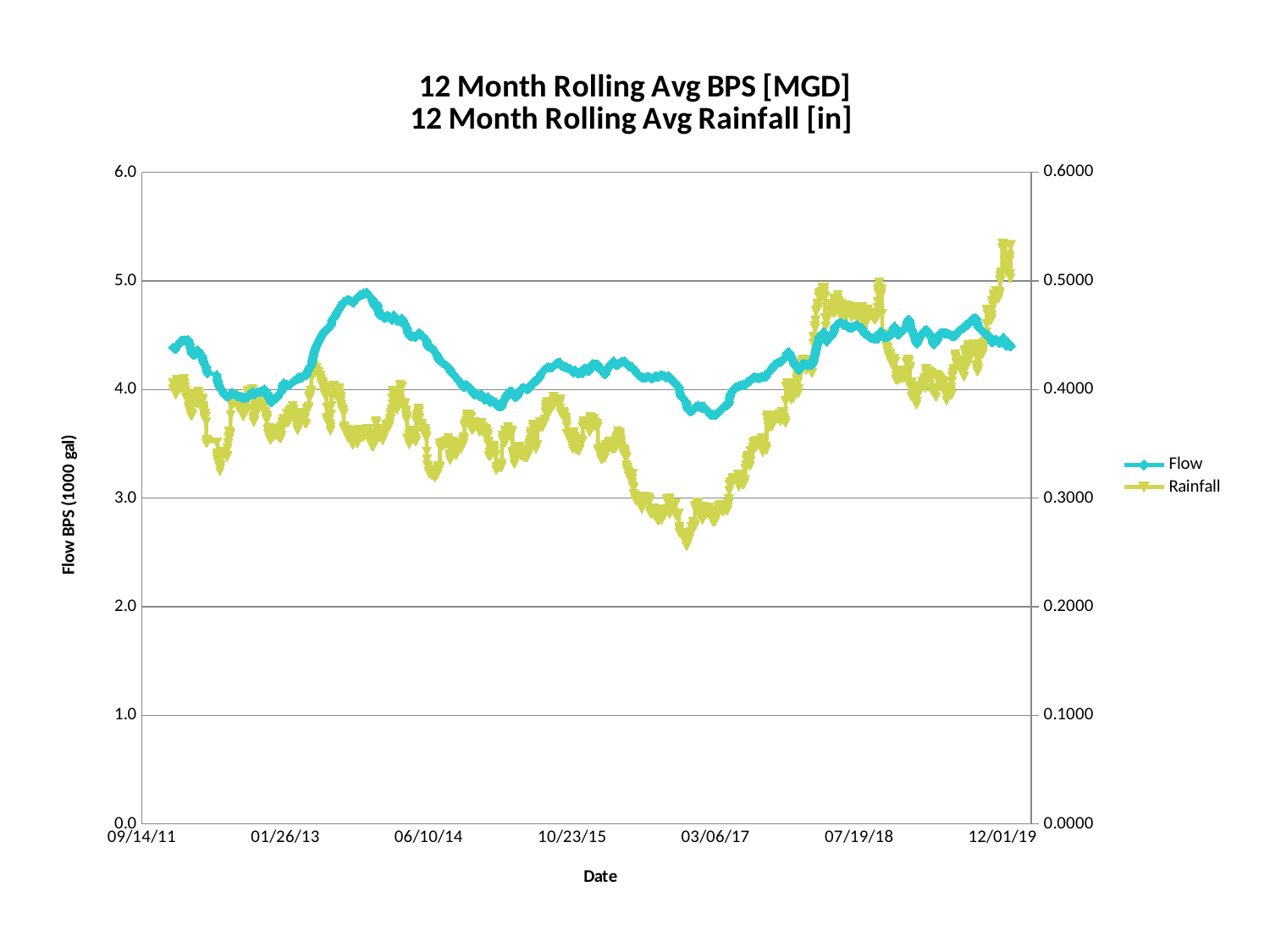
Does the Rainfall series rise or fall between 03/06/17 and 07/19/18? rise What is the label of the left vertical axis? Flow BPS (1000 gal) Does the Flow series rise or fall between 06/10/14 and mid-2015? fall What kind of chart is shown on the slide? line chart Around which date does the Rainfall series reach its highest value? 12/01/19 Is the lowest Rainfall value on the chart greater or less than 0.3000? less How many series does the legend list? 2 What are the two series named in the legend? Flow and Rainfall Is the Rainfall value at 12/01/19 greater or less than 0.5000? greater Is the Flow value around 03/06/17 greater or less than 4.0? less